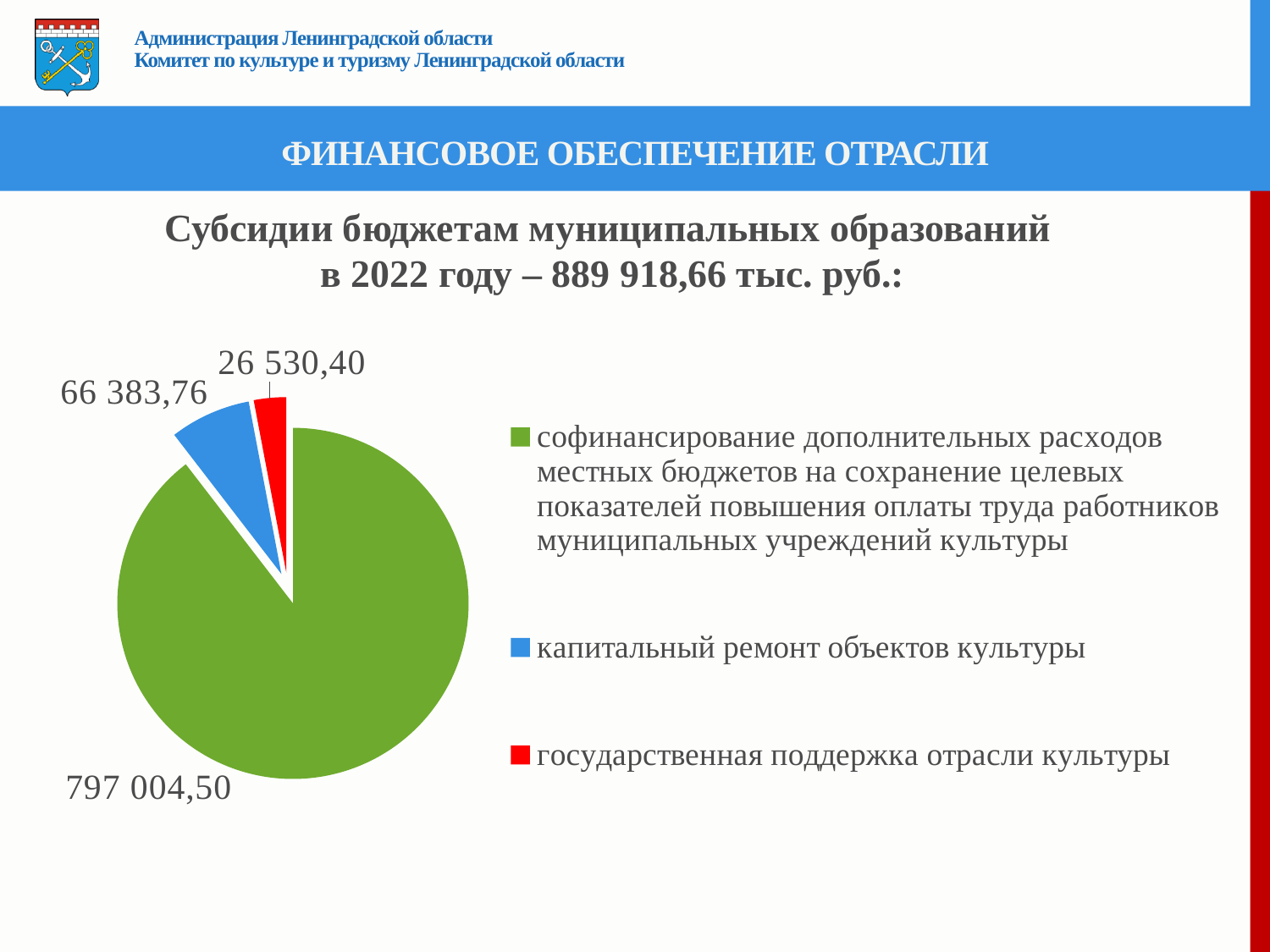
What is the difference between the values for «капитальный ремонт объектов культуры» and «государственная поддержка отрасли культуры»? 39 853,36 What is the value of the slice for «капитальный ремонт объектов культуры»? 66 383,76 Which category has the largest slice in the pie chart? софинансирование дополнительных расходов местных бюджетов на сохранение целевых показателей повышения оплаты труда работников муниципальных учреждений культуры What is the value of the slice for «софинансирование дополнительных расходов местных бюджетов на сохранение целевых показателей повышения оплаты труда работников муниципальных учреждений культуры»? 797 004,50 Which category has the smallest slice in the pie chart? государственная поддержка отрасли культуры What type of chart is shown on the slide? pie chart What colour is the slice for «государственная поддержка отрасли культуры»? red How many slices does the pie chart have? 3 What is the value of the slice for «государственная поддержка отрасли культуры»? 26 530,40 How many entries does the legend of the pie chart list? 3 Which is larger: the slice for «капитальный ремонт объектов культуры» or the slice for «государственная поддержка отрасли культуры»? капитальный ремонт объектов культуры What is the total of all three slices in the pie chart? 889 918,66